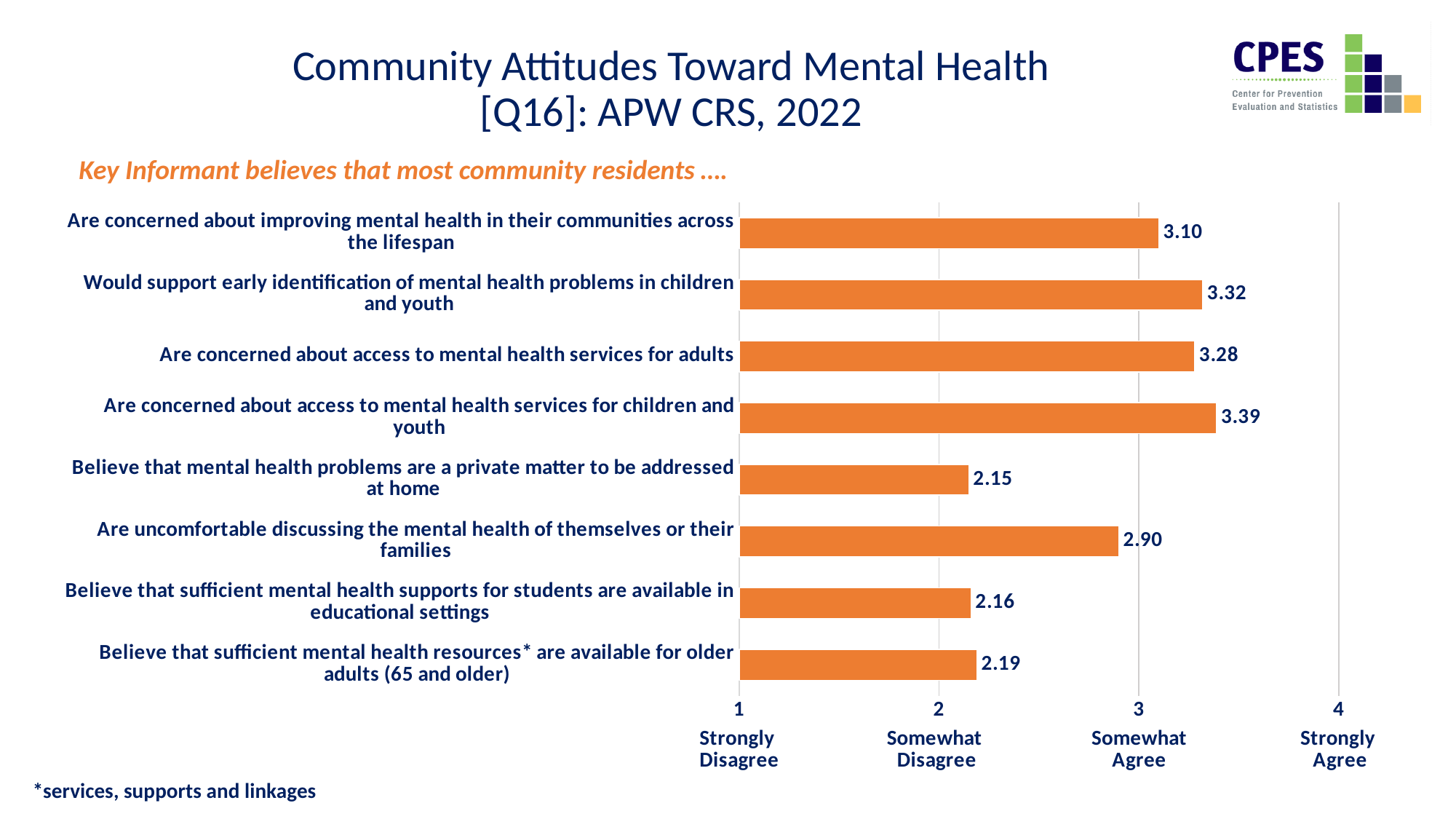
Which category has the lowest value? Believe that mental health problems are a private matter to be addressed at home Which is larger: the value for 'Are concerned about access to mental health services for adults' or the value for 'Are uncomfortable discussing the mental health of themselves or their families'? Are concerned about access to mental health services for adults What is the difference between the values for 'Would support early identification of mental health problems in children and youth' and 'Are concerned about improving mental health in their communities across the lifespan'? 0.22 What axis label corresponds to the value 4 on the scale? Strongly Agree What does the asterisk (*) in 'mental health resources*' refer to, according to the footnote? services, supports and linkages What is the value for 'Are concerned about access to mental health services for children and youth'? 3.39 What is the value for 'Are uncomfortable discussing the mental health of themselves or their families'? 2.90 How many categories are shown in the chart? 8 Which category has the highest value? Are concerned about access to mental health services for children and youth What kind of chart is shown on the slide? bar chart Is the value for 'Believe that sufficient mental health resources* are available for older adults (65 and older)' greater or less than 3? less What is the value for 'Believe that mental health problems are a private matter to be addressed at home'? 2.15